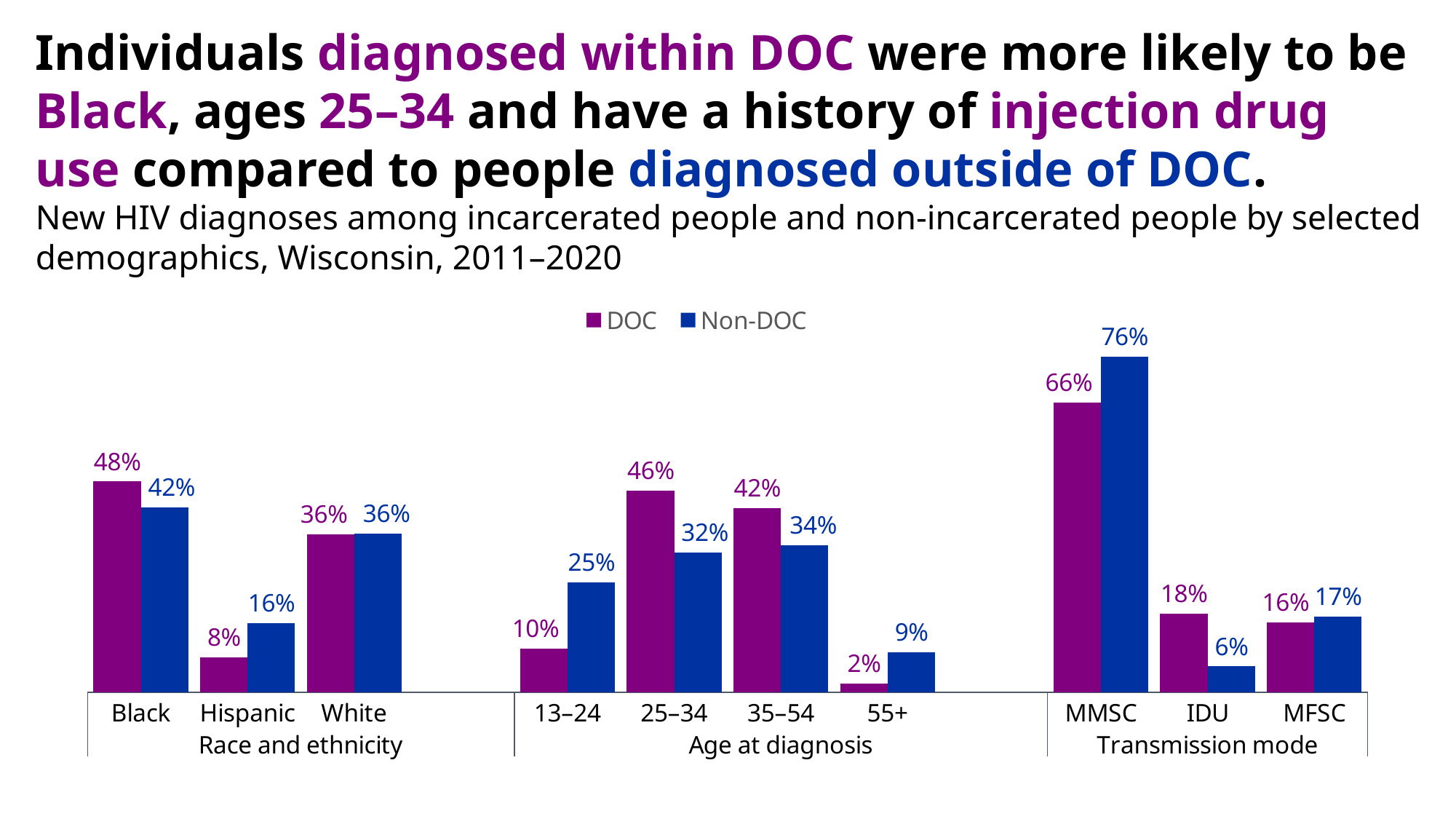
What is the Non-DOC value for the 13–24 age group? 25% Which is larger for Hispanic, the DOC value or the Non-DOC value? Non-DOC What is the difference between the DOC and Non-DOC values for 25–34? 14% What is the Non-DOC value for IDU? 6% Which category has the highest Non-DOC value? MMSC What is the DOC value for Black? 48% What is the difference between the Non-DOC and DOC values for MMSC? 10% How many series does the legend list? 2 Which is larger for IDU, the DOC value or the Non-DOC value? DOC How many categories are shown on the x axis? 10 What kind of chart is shown? Bar chart Which category has the lowest DOC value? 55+